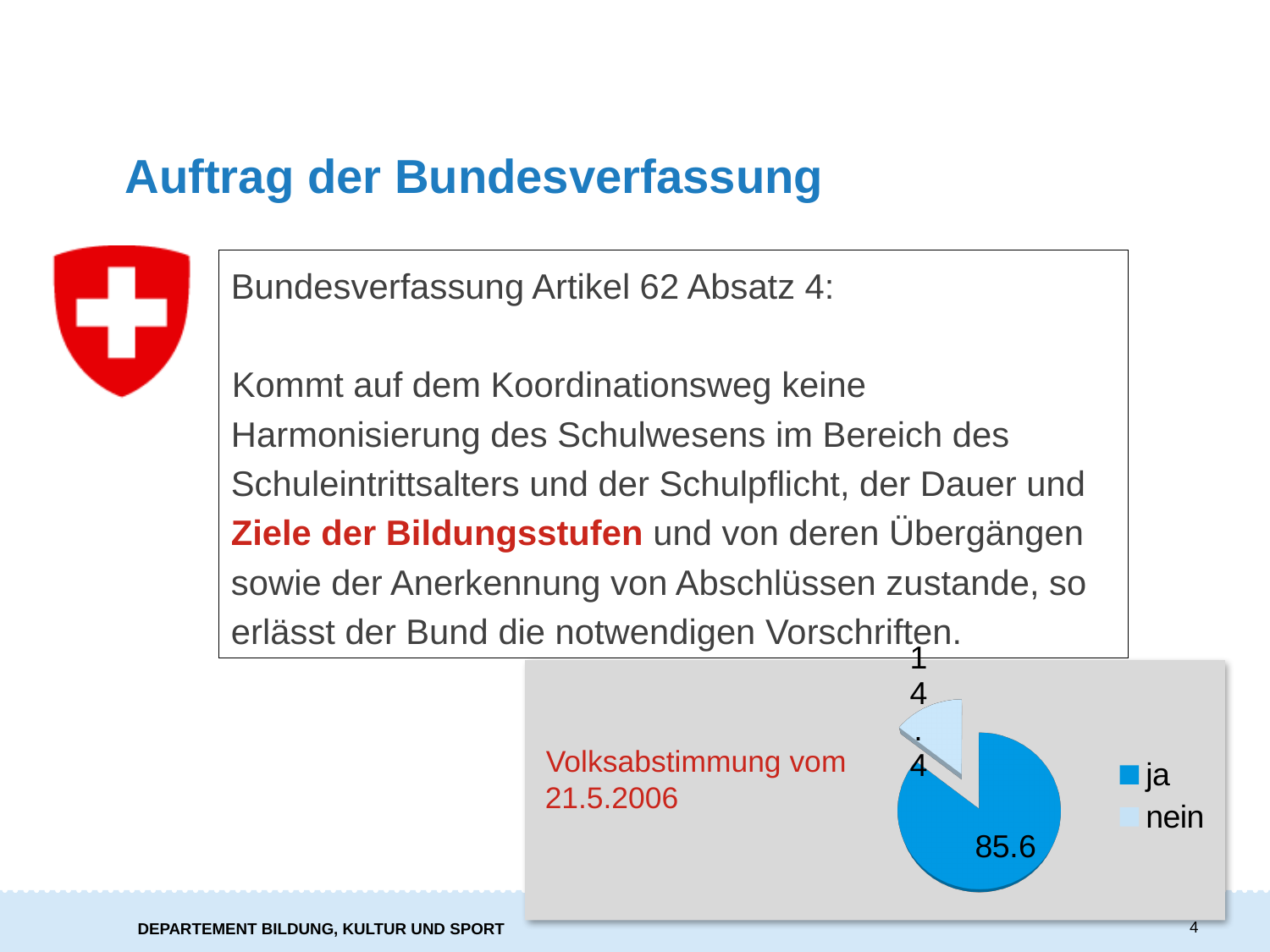
Which slice of the pie chart is the smallest? nein What is the value of the "nein" slice in the pie chart? 14.4 Which is larger in the pie chart, "ja" or "nein"? ja What is the difference between the "ja" and "nein" values in the pie chart? 71.2 Which slice of the pie chart is the largest? ja What is the value of the "ja" slice in the pie chart? 85.6 How many entries does the legend of the pie chart list? 2 What date is given for the Volksabstimmung next to the pie chart? 21.5.2006 What colour is the "ja" slice in the pie chart? blue How many slices does the pie chart have? 2 What type of chart is shown on the slide? pie chart